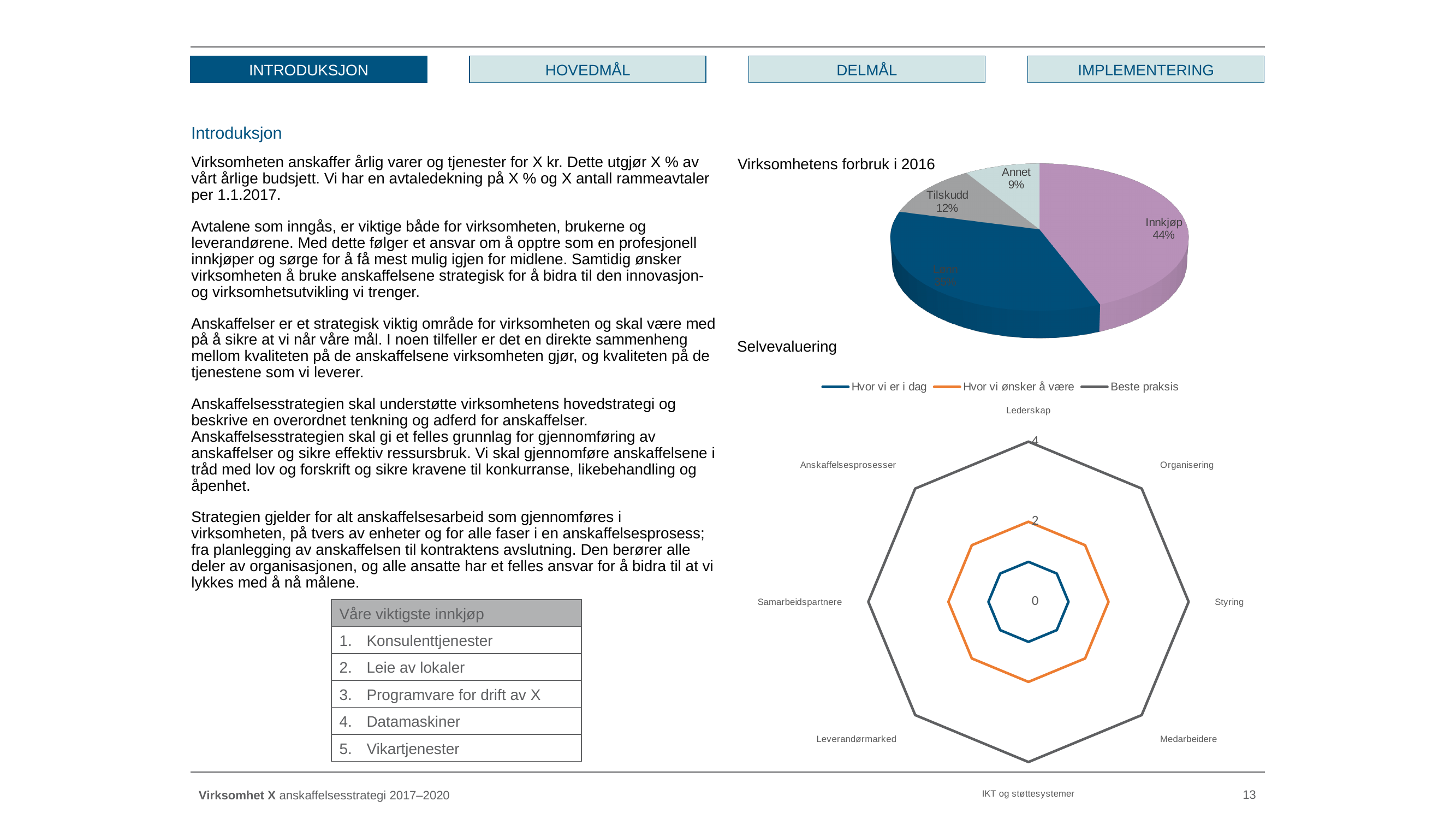
In the 'Selvevaluering' chart, what is the value of Beste praksis for Lederskap? 4 What kind of chart is 'Selvevaluering'? Radar chart In the 'Selvevaluering' chart, is the value of 'Hvor vi er i dag' for Lederskap greater or less than 2? less What kind of chart is 'Virksomhetens forbruk i 2016'? Pie chart In the pie chart 'Virksomhetens forbruk i 2016', which is larger, Tilskudd or Annet? Tilskudd In the pie chart 'Virksomhetens forbruk i 2016', what share does Innkjøp have? 44% In the pie chart 'Virksomhetens forbruk i 2016', what is the difference between Innkjøp and Tilskudd? 32% How many series does the legend of the 'Selvevaluering' chart list? 3 In the pie chart 'Virksomhetens forbruk i 2016', which slice is the smallest? Annet In the pie chart 'Virksomhetens forbruk i 2016', what is the value for Tilskudd? 12% In the pie chart 'Virksomhetens forbruk i 2016', what is the value for Annet? 9% In the pie chart 'Virksomhetens forbruk i 2016', which slice is the largest? Innkjøp